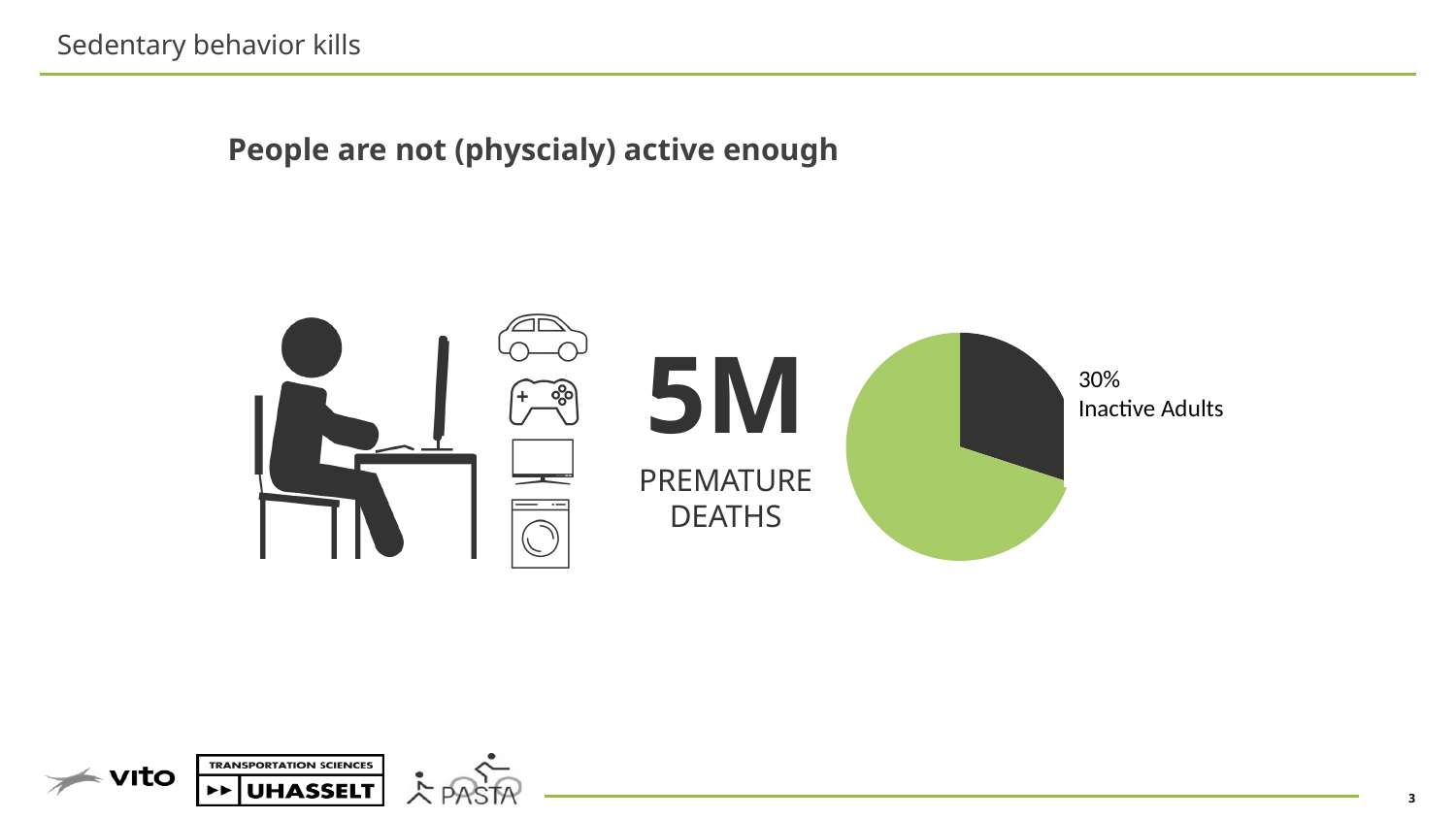
Which slice of the pie chart is the smallest? Inactive Adults Is the share of Inactive Adults in the pie chart greater or less than 50%? less What kind of chart is shown on the slide? pie chart How many slices does the pie chart have? 2 What is the label of the dark grey slice of the pie chart? Inactive Adults Which slice of the pie chart is larger, the green slice or the dark grey slice? the green slice What colour is the slice representing Inactive Adults in the pie chart? dark grey What share of the pie chart is labelled as Inactive Adults? 30%